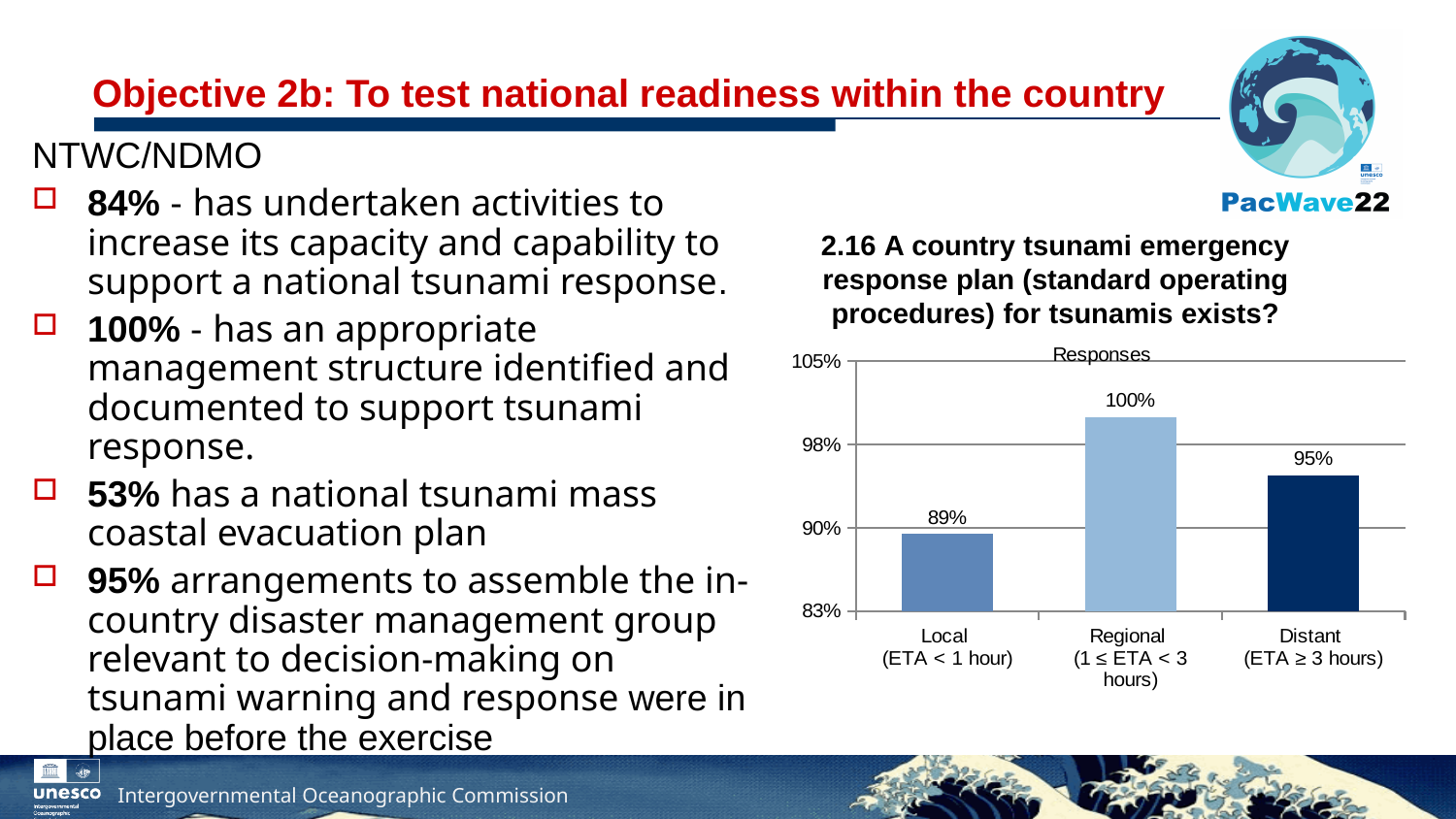
How many categories are shown on the x axis of the chart? 3 What is the value for Local (ETA < 1 hour) in the chart? 89% What is the difference between the Distant and Local values in the chart? 6% Which is larger in the chart, the value for Distant or the value for Local? Distant Is the value for Local (ETA < 1 hour) greater or less than 90%? less Which category has the lowest value in the chart? Local (ETA < 1 hour) What is the value for Distant (ETA ≥ 3 hours) in the chart? 95% What kind of chart is shown on the slide? bar chart What is the value for Regional (1 ≤ ETA < 3 hours) in the chart? 100% What is the difference between the Regional and Local values in the chart? 11% Which category has the highest value in the chart? Regional (1 ≤ ETA < 3 hours) What is the title of the chart on the slide? Responses